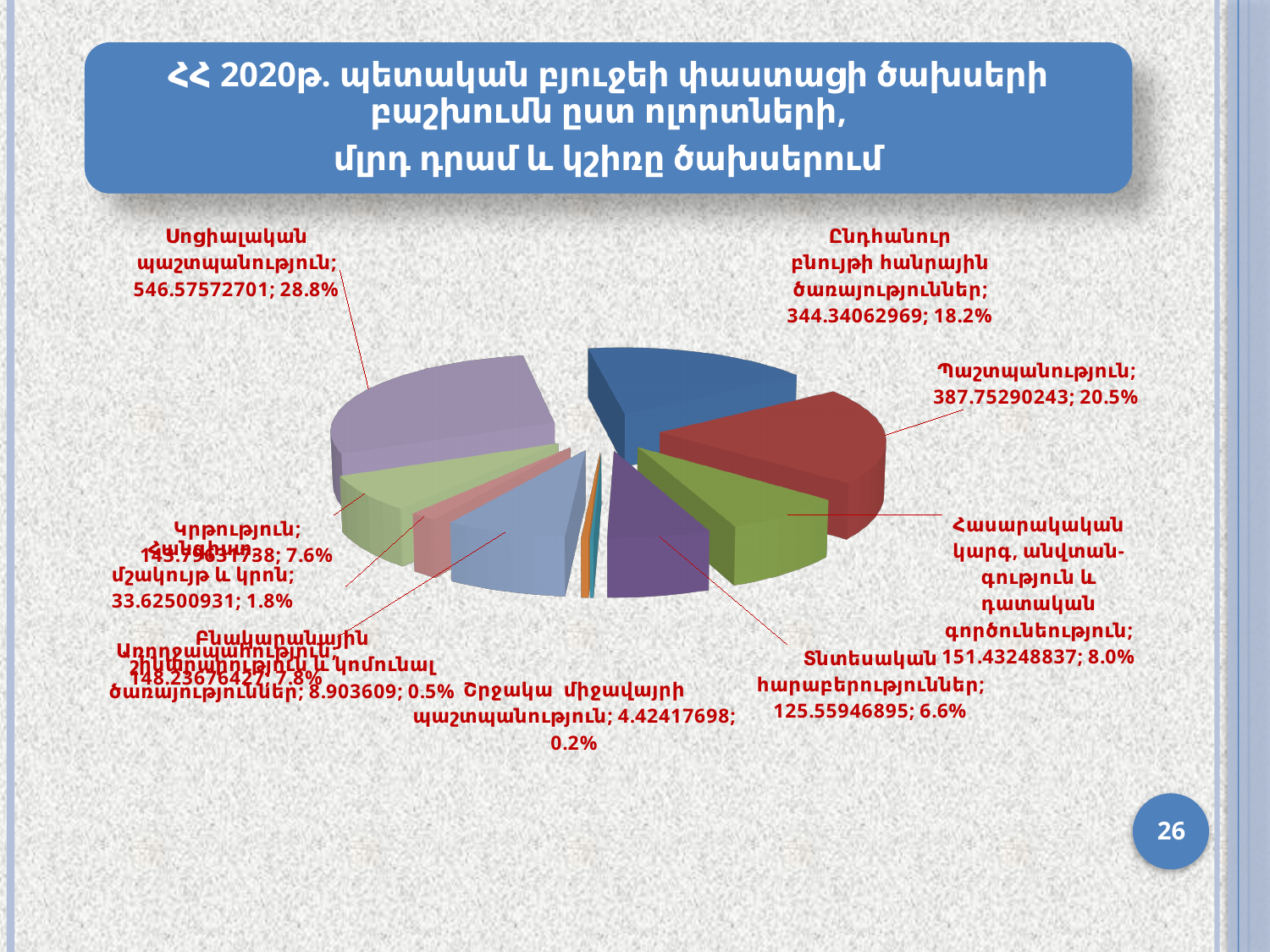
What share of expenditures does Պաշտպանություն account for? 20.5% What value is shown for Սոցիալական պաշտպանություն? 546.57572701 What is the difference between the values for Պաշտպանություն and Ընդհանուր բնույթի հանրային ծառայություններ? 43.41227274 What value is shown for Հասարակական կարգ, անվտանգություն և դատական գործունեություն? 151.43248837 Which is larger: Պաշտպանություն or Ընդհանուր բնույթի հանրային ծառայություններ? Պաշտպանություն Which is larger: Տնտեսական հարաբերություններ or Հանգիստ, մշակույթ և կրոն? Տնտեսական հարաբերություններ How many sectors are shown in the pie chart? 10 What is the difference in percentage share between Սոցիալական պաշտպանություն and Ընդհանուր բնույթի հանրային ծառայություններ? 10.6 percentage points What share of expenditures does Տնտեսական հարաբերություններ account for? 6.6% Which sector has the largest slice of the pie? Սոցիալական պաշտպանություն Which sector has the smallest slice of the pie? Շրջակա միջավայրի պաշտպանություն What kind of chart is shown on the slide? Pie chart